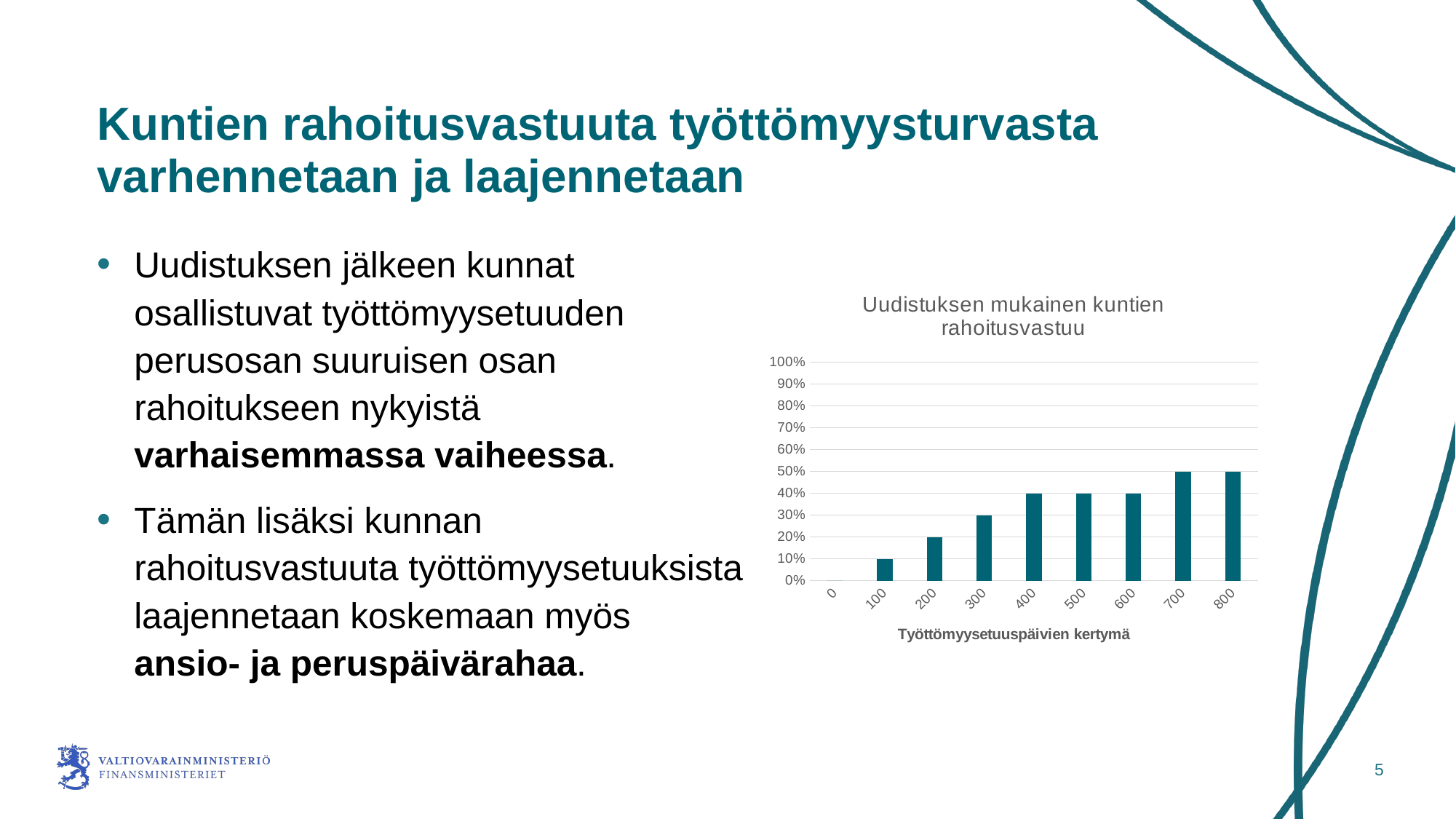
Which category has the lowest value on the chart? 0 What is the title of the chart? Uudistuksen mukainen kuntien rahoitusvastuu What is the value for 500 on the chart? 40% What is the value for 300 on the chart? 30% What is the value for 100 on the chart? 10% What kind of chart is shown on the slide? bar chart How many categories are shown on the x axis of the chart? 9 What is the value for 800 on the chart? 50% Do the values generally rise or fall as the x-axis values increase? rise What is the x-axis title of the chart? Työttömyysetuuspäivien kertymä Which is larger, the value for 400 or the value for 200? 400 What is the difference between the values for 700 and 200? 30%